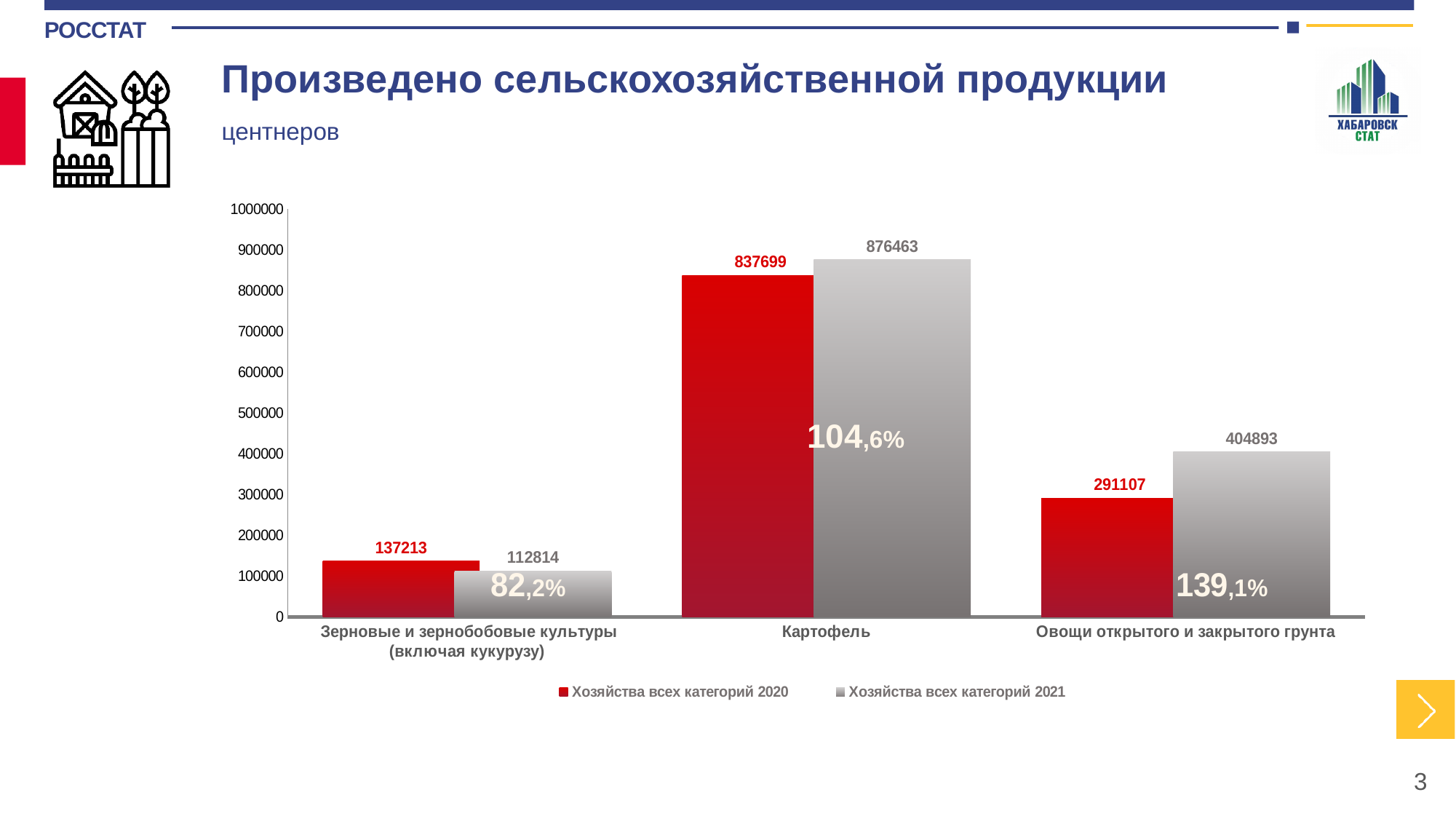
What is the value for Овощи открытого и закрытого грунта in the series Хозяйства всех категорий 2021? 404893 What kind of chart is shown on the slide? Bar chart What is the value for Зерновые и зернобобовые культуры (включая кукурузу) in the series Хозяйства всех категорий 2021? 112814 How many categories are shown on the x axis of the chart? 3 What is the difference between the 2021 and 2020 values for Картофель? 38764 How many series does the legend list? 2 What percentage label is printed on the 2021 bar for Овощи открытого и закрытого грунта? 139,1% Which category has the highest value in the series Хозяйства всех категорий 2021? Картофель For Зерновые и зернобобовые культуры (включая кукурузу), which series has the larger value: Хозяйства всех категорий 2020 or Хозяйства всех категорий 2021? Хозяйства всех категорий 2020 What is the difference between the 2021 and 2020 values for Овощи открытого и закрытого грунта? 113786 What is the value for Картофель in the series Хозяйства всех категорий 2020? 837699 Which category has the lowest value in the series Хозяйства всех категорий 2020? Зерновые и зернобобовые культуры (включая кукурузу)